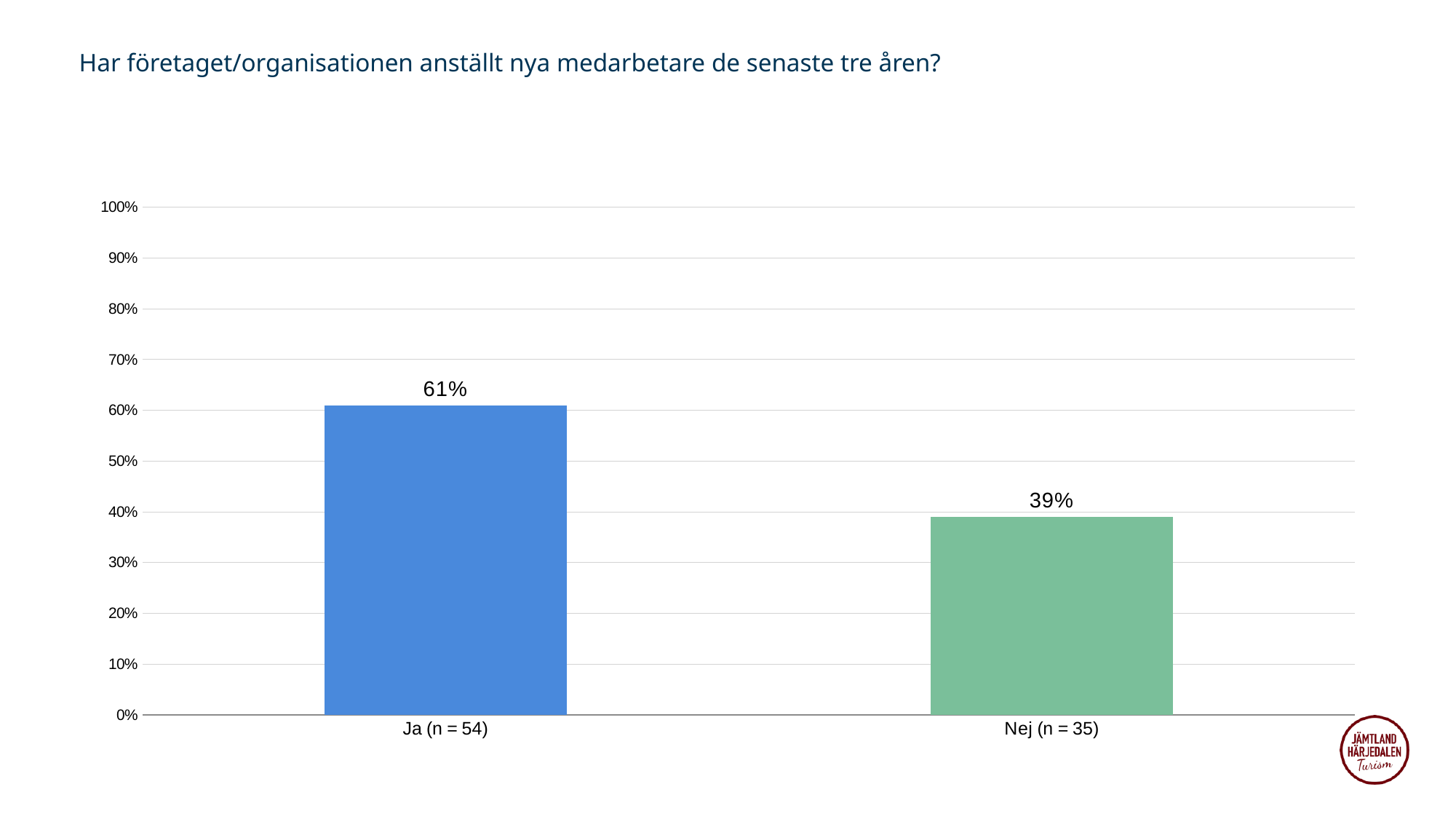
What is the value for Nej (n = 35)? 39% What kind of chart is shown on the slide? Bar chart What is the difference between the values for Ja (n = 54) and Nej (n = 35)? 22% Which category has the lowest value? Nej (n = 35) Which category has the highest value? Ja (n = 54) What is the title of the slide? Har företaget/organisationen anställt nya medarbetare de senaste tre åren? How many categories are shown in the chart? 2 Is the value for Ja (n = 54) greater or less than 50%? greater Is the value for Nej (n = 35) greater or less than 50%? less What is the value for Ja (n = 54)? 61% What colour is the bar for Ja (n = 54)? Blue Which is larger, the value for Ja (n = 54) or the value for Nej (n = 35)? Ja (n = 54)